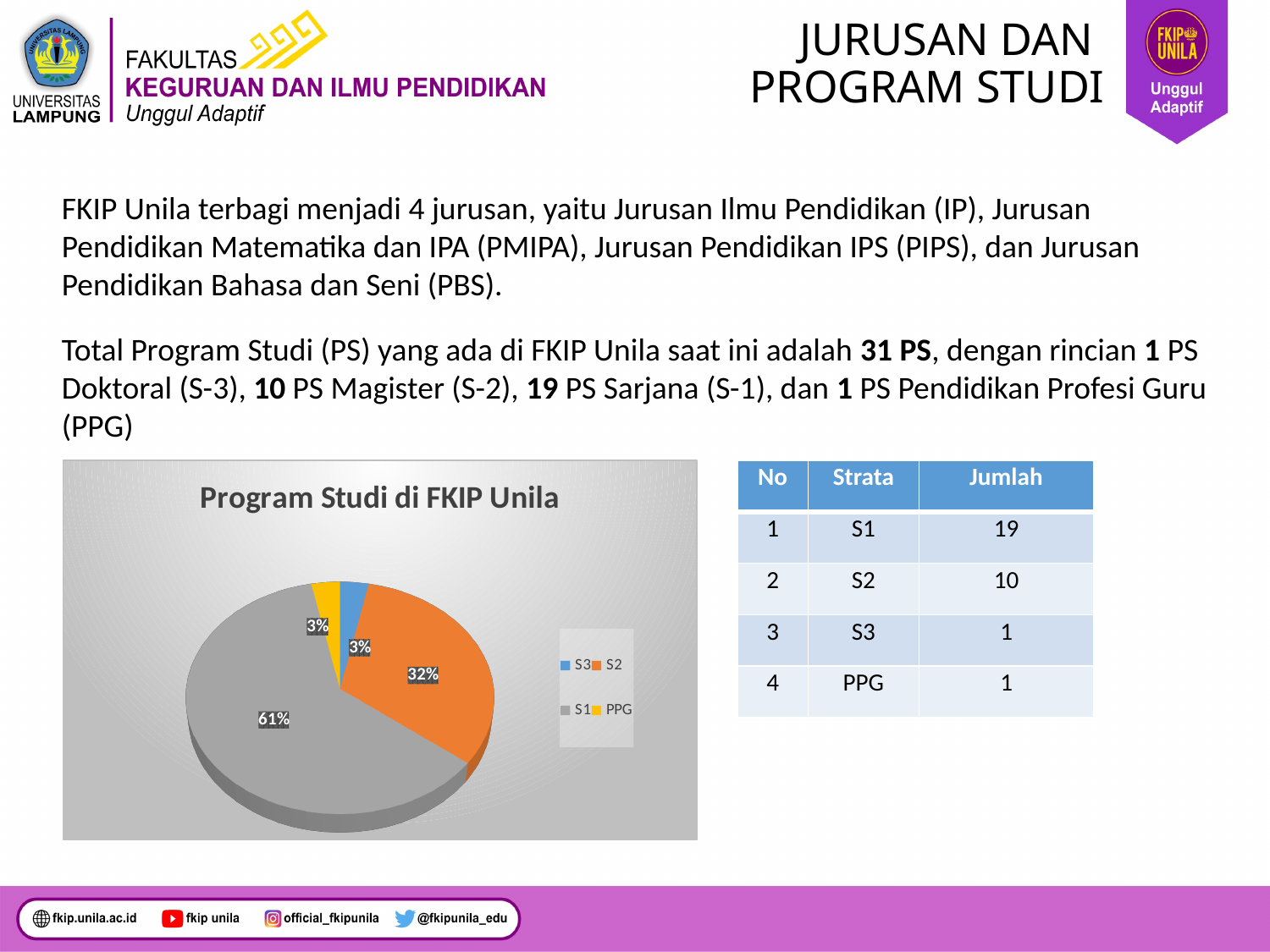
How many entries does the legend list? 4 Which is larger, the slice for S2 or the slice for S1? S1 What share of the pie does S2 represent? 32% What is the title of the chart? Program Studi di FKIP Unila What share of the pie does S1 represent? 61% Which category has the largest slice of the pie? S1 How many slices does the pie chart have? 4 What type of chart is shown on the slide? pie chart What share of the pie does S3 represent? 3% What share of the pie does PPG represent? 3% What is the difference in percentage points between the S1 slice and the S2 slice? 29 What colour is the S1 slice in the pie chart? gray